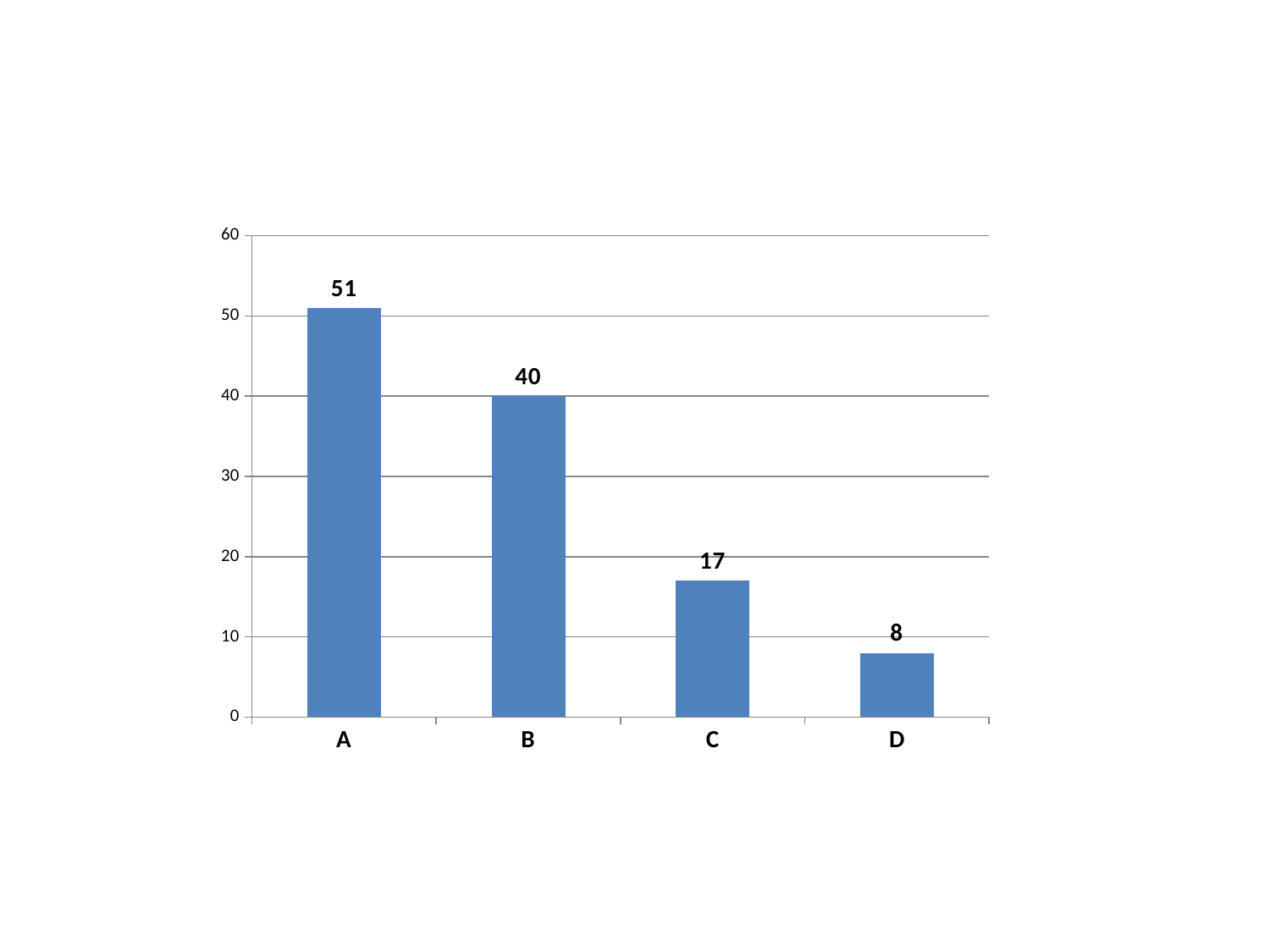
Is the value for C greater or less than 20? less What is the difference between the values for A and B? 11 What is the value for category D? 8 How many categories are shown on the x axis? 4 What is the value for category B? 40 What is the difference between the values for C and D? 9 Which category has the lowest value? D What is the value for category C? 17 Which is larger, the value for B or the value for C? B What kind of chart is shown on the slide? bar chart What is the value for category A? 51 Which category has the highest value? A